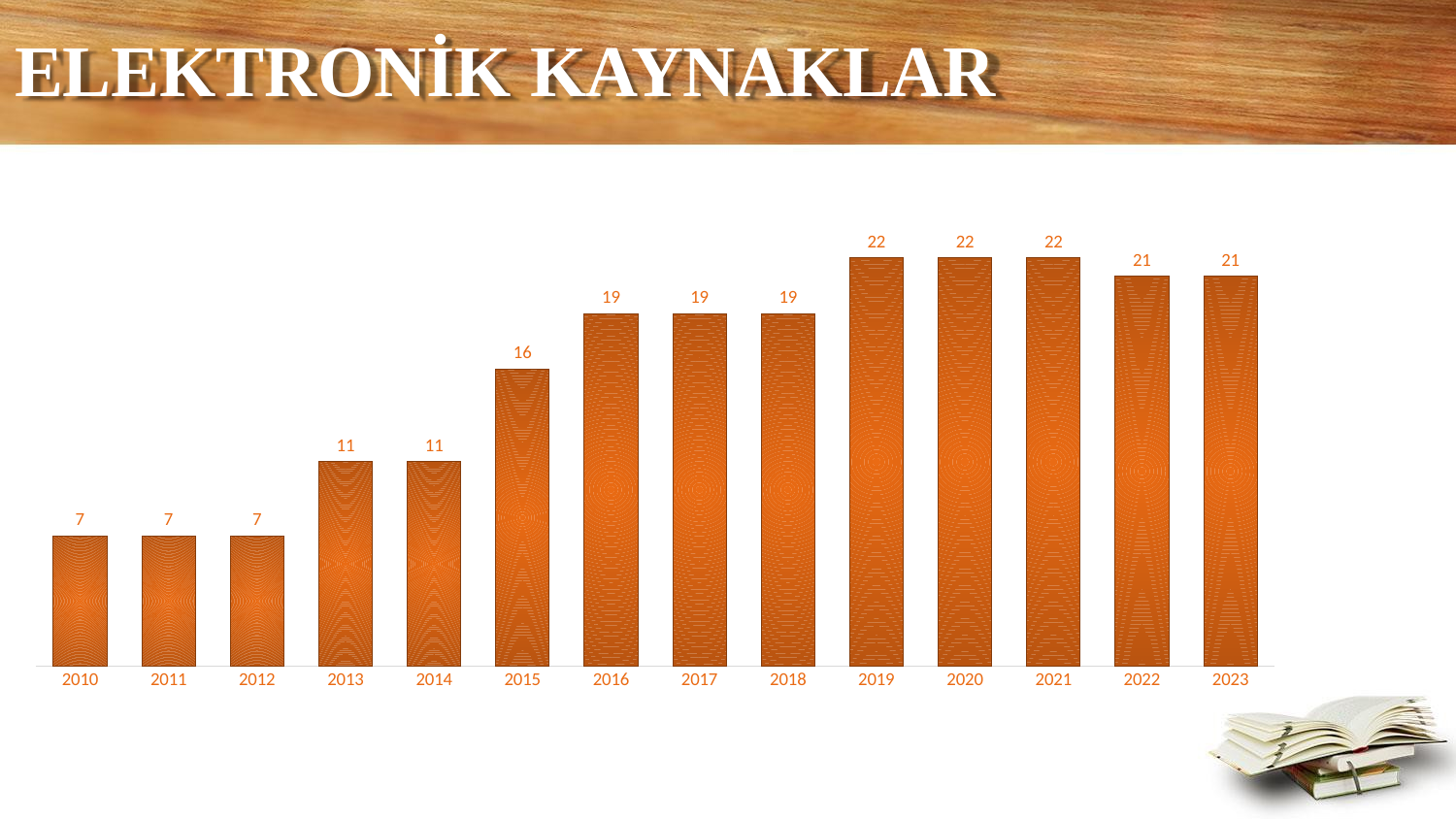
How many years are shown on the x axis? 14 What kind of chart is shown on the slide? Bar chart What is the title of the slide? ELEKTRONİK KAYNAKLAR What is the difference between the values for 2019 and 2013? 11 Which is larger, the value for 2016 or the value for 2022? 2022 Which years have the highest value? 2019, 2020 and 2021 What is the value for 2023? 21 Do the values generally rise or fall from 2010 to 2021? Rise What is the value for 2015? 16 What is the lowest value shown in the chart? 7 What is the value for 2010? 7 What colour are the bars in the chart? Orange